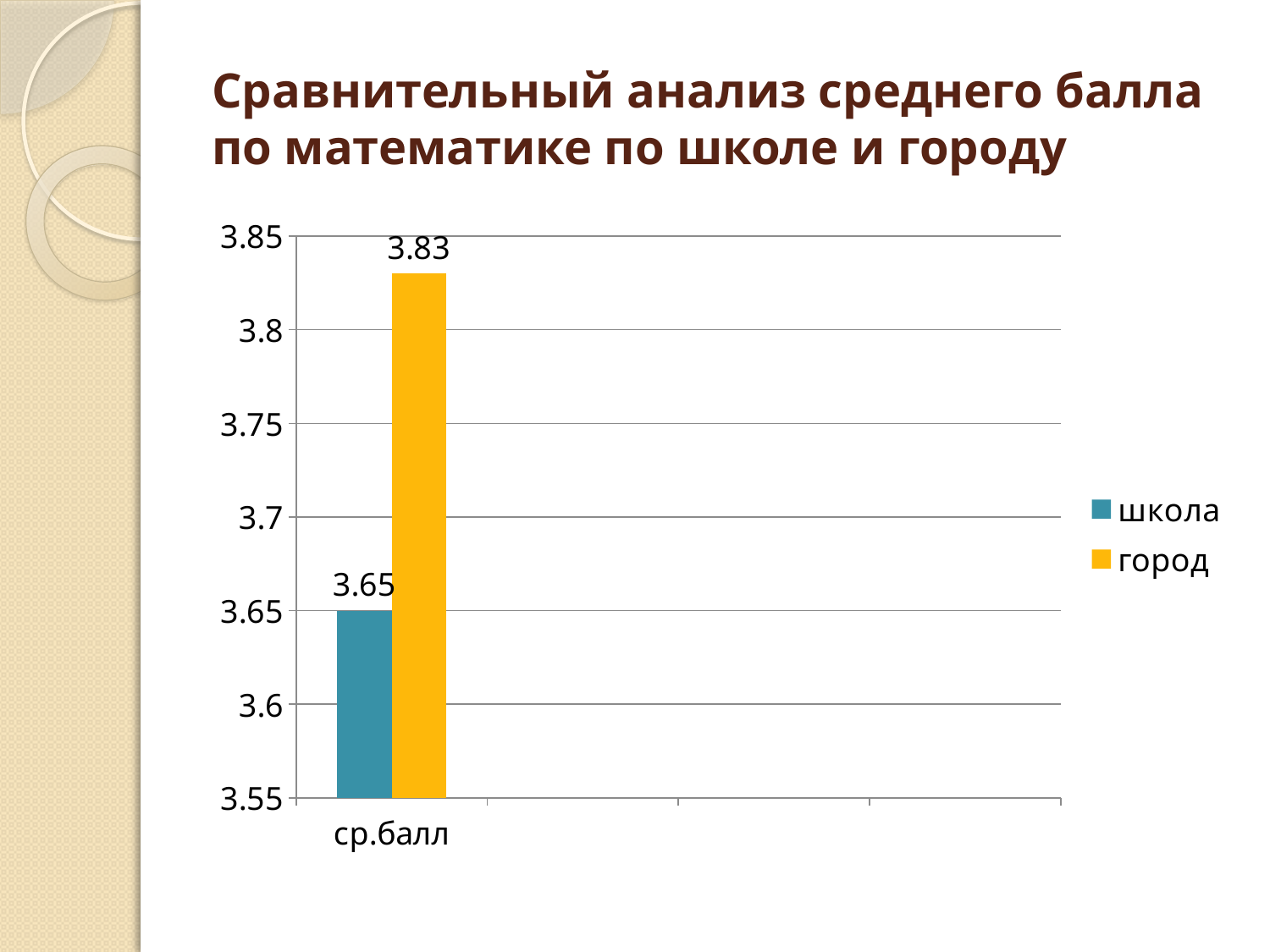
What is the difference between the город value and the школа value? 0.18 Which series has the higher value: школа or город? город Is the value for город greater or less than 3.8? greater Is the value for школа greater or less than 3.7? less What kind of chart is shown on the slide? bar chart What is the value for школа in the ср.балл category? 3.65 How many series does the legend list? 2 Which series has the lowest value on the chart? школа What is the label of the category on the x axis? ср.балл What is the value for город in the ср.балл category? 3.83 How many categories are shown on the x axis? 1 What colour is the bar for город? yellow